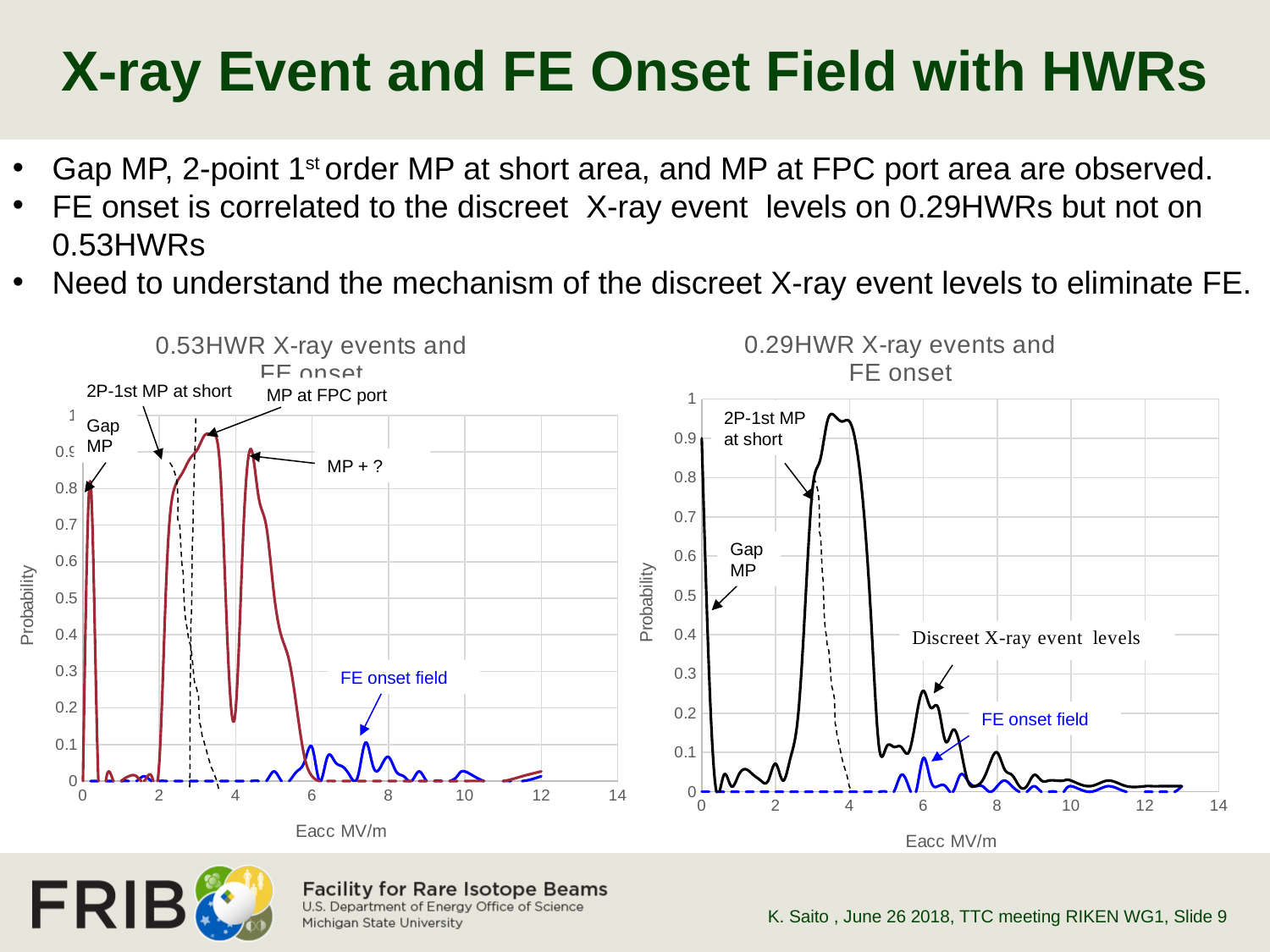
What is the maximum value shown on the x axis of the "0.29HWR X-ray events and FE onset" chart? 14 How many charts are shown on the slide? 2 In the "0.53HWR X-ray events and FE onset" chart, is the probability of the red curve at the "MP at FPC port" peak greater or less than 0.8? greater In the "0.53HWR X-ray events and FE onset" chart, is the probability of the red curve at the "MP + ?" peak greater or less than 0.7? greater In the "0.29HWR X-ray events and FE onset" chart, is the peak of the "Discreet X-ray event levels" bump near Eacc 6 MV/m greater or less than 0.3? less What colour is the "FE onset field" curve in the "0.29HWR X-ray events and FE onset" chart? blue What is the label of the y axis on the "0.53HWR X-ray events and FE onset" chart? Probability What kind of chart is the "0.53HWR X-ray events and FE onset" chart? line chart